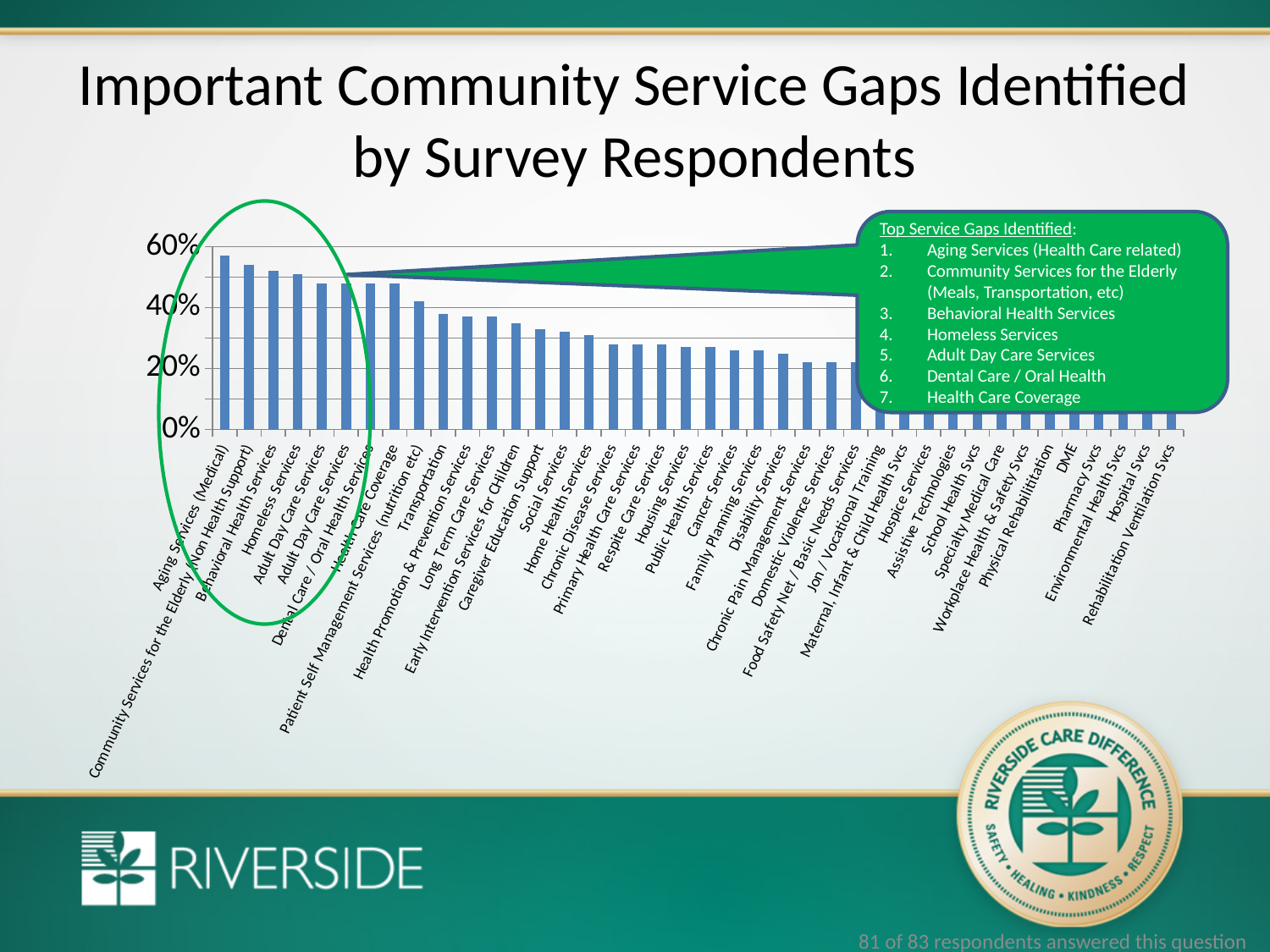
What kind of chart is shown on the slide? bar chart Which has a larger value, Homeless Services or Housing Services? Homeless Services Is the value for Behavioral Health Services greater or less than 40%? greater Is the value for Transportation greater or less than 40%? less Which category has the highest value in the chart? Aging Services (Medical) What is the title of the chart on the slide? Important Community Service Gaps Identified by Survey Respondents Do the bar values generally rise or fall from left to right along the x axis? fall Which has a larger value, Aging Services (Medical) or Transportation? Aging Services (Medical) According to the callout box, what is the number one top service gap identified? Aging Services (Health Care related) Is the value for Social Services greater or less than 20%? greater